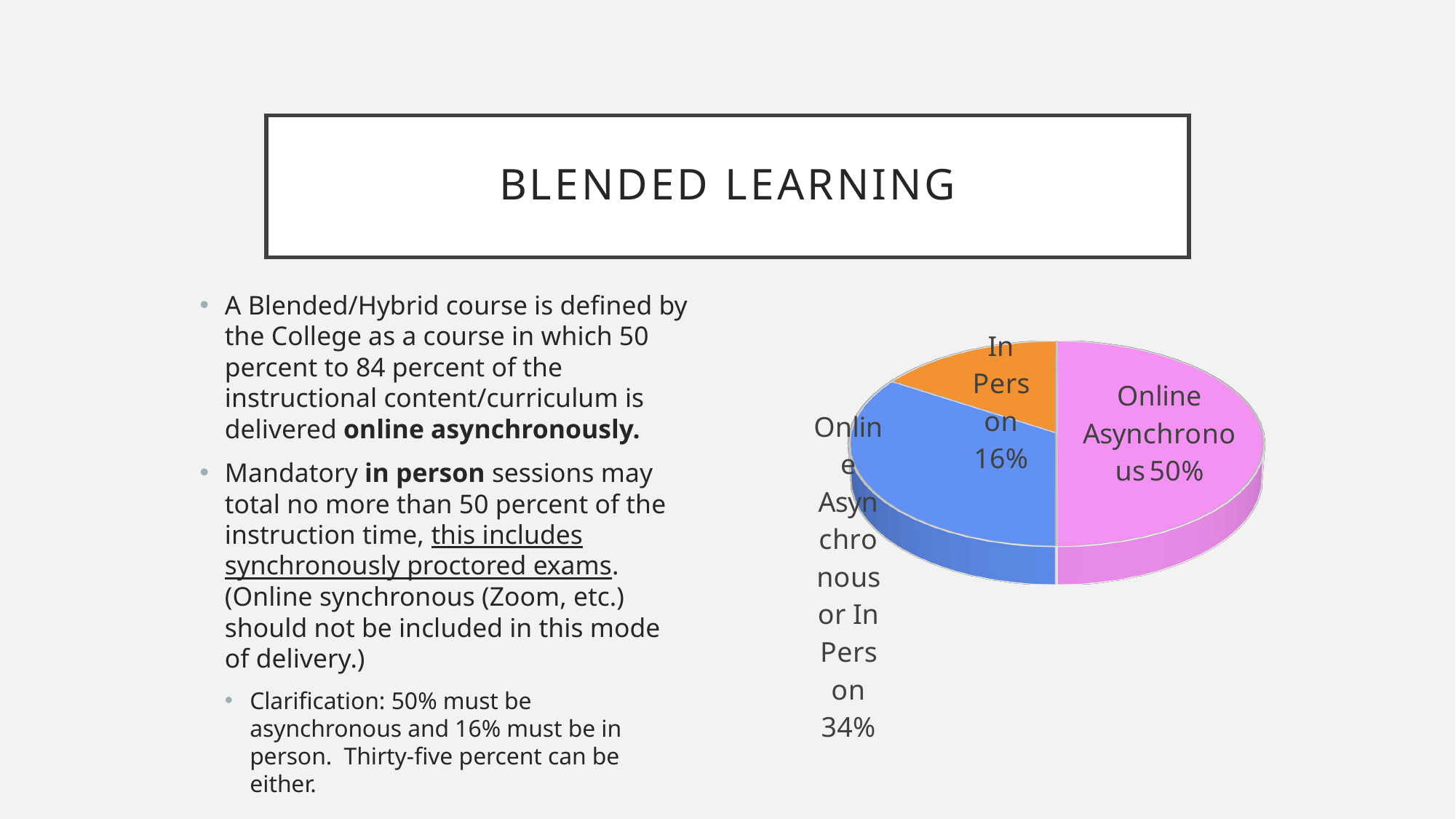
What percentage does the In Person slice represent? 16% What colour is the In Person slice? orange Which slice of the pie chart is the smallest? In Person What is the difference between the Online Asynchronous or In Person slice and the In Person slice? 18% What is the difference between the Online Asynchronous slice and the In Person slice? 34% What kind of chart is shown on the slide? pie chart Which is larger, the In Person slice or the Online Asynchronous or In Person slice? Online Asynchronous or In Person How many slices does the pie chart have? 3 What colour is the Online Asynchronous slice? pink What percentage does the Online Asynchronous slice represent? 50% Which slice of the pie chart is the largest? Online Asynchronous What percentage does the Online Asynchronous or In Person slice represent? 34%